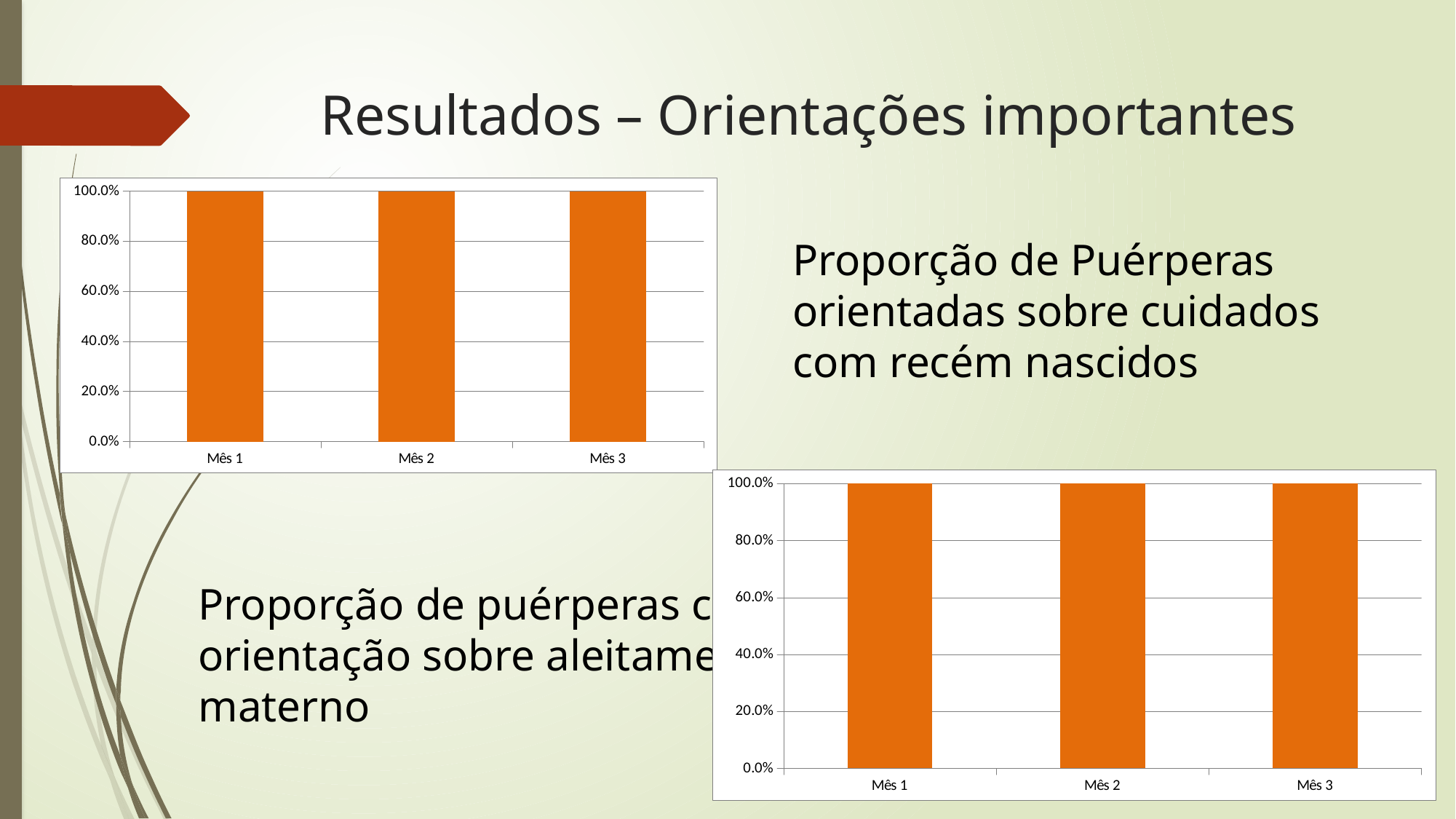
In the top-left chart, what is the value for Mês 3? 100.0% In the top-left chart, how many categories are shown on the x axis? 3 What colour are the bars in the bottom-right chart? orange In the bottom-right chart, what is the value for Mês 2? 100.0% In the top-left chart, is the value for Mês 2 greater or less than 80.0%? greater What type of chart is the bottom-right chart on the slide? bar chart In the bottom-right chart, what is the difference between the values for Mês 1 and Mês 3? 0.0% In the bottom-right chart, is the value for Mês 3 greater or less than 60.0%? greater In the top-left chart, what is the value for Mês 1? 100.0% What type of chart is the top-left chart on the slide? bar chart In the bottom-right chart, how many bars are plotted? 3 In the top-left chart, do the values rise, fall or stay the same from Mês 1 to Mês 3? stay the same